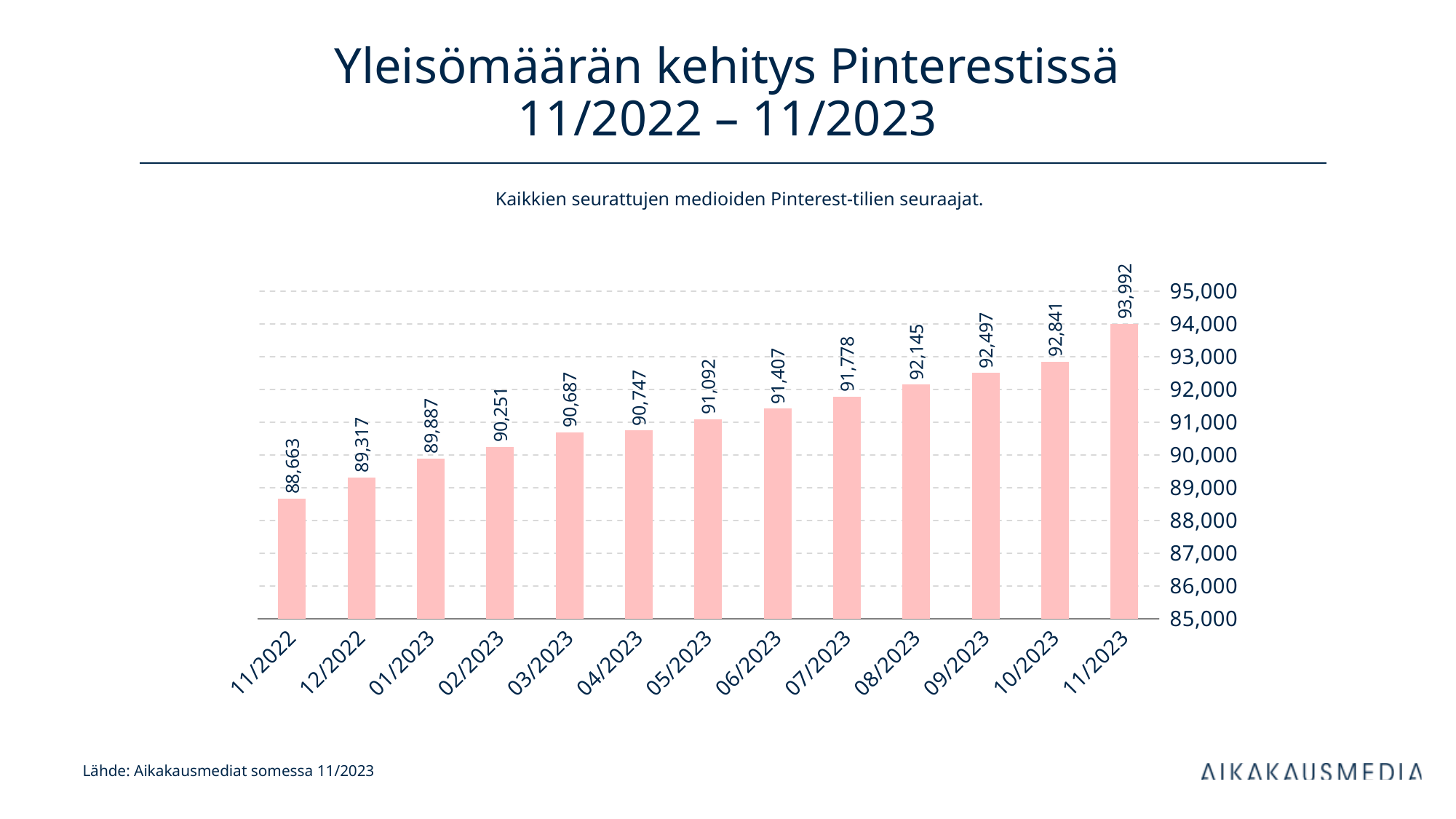
What kind of chart is shown on the slide? bar chart What is the value for 11/2022? 88,663 What is the difference between the values for 11/2023 and 11/2022? 5,329 Which is larger, the value for 03/2023 or the value for 06/2023? 06/2023 What is the value for 11/2023? 93,992 What is the difference between the values for 10/2023 and 09/2023? 344 What is the value for 05/2023? 91,092 Do the values rise or fall from 11/2022 to 11/2023? rise Which month has the lowest value? 11/2022 Is the value for 08/2023 greater or less than 92,000? greater Which month has the highest value? 11/2023 How many months are shown on the x axis? 13